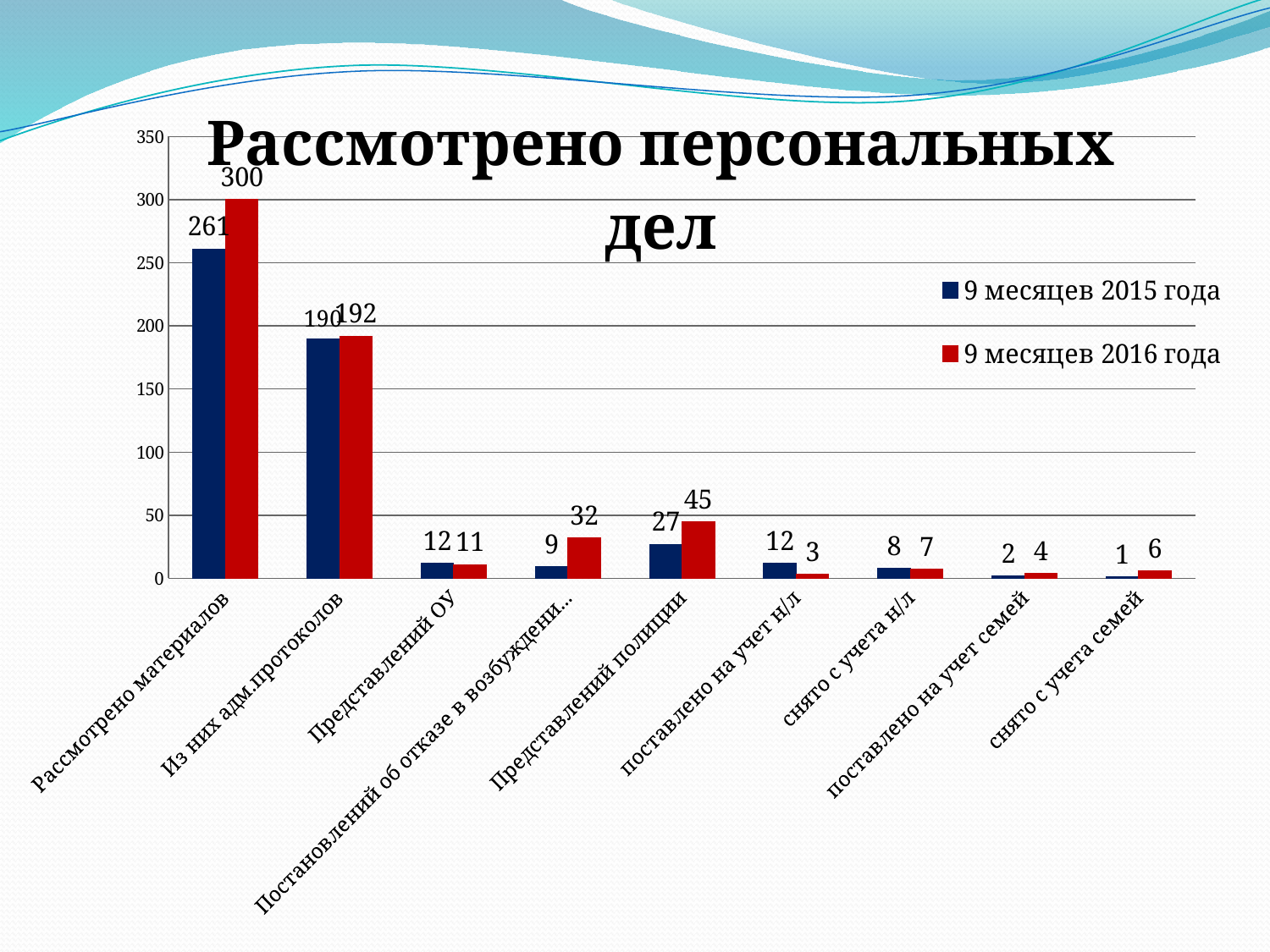
What is the value for "Рассмотрено материалов" in the "9 месяцев 2016 года" series? 300 What is the difference between the "9 месяцев 2016 года" and "9 месяцев 2015 года" values for "Рассмотрено материалов"? 39 Which category has the lowest value in the "9 месяцев 2015 года" series? снято с учета семей How many series does the legend list? 2 What is the value for "Представлений полиции" in the "9 месяцев 2016 года" series? 45 What is the title of the chart? Рассмотрено персональных дел Is the value for "Из них адм.протоколов" in the "9 месяцев 2016 года" series greater or less than 150? greater What is the value for "Из них адм.протоколов" in the "9 месяцев 2015 года" series? 190 Which category has the highest value in the "9 месяцев 2015 года" series? Рассмотрено материалов What type of chart is shown on the slide? bar chart For "поставлено на учет н/л", which series has the larger value, "9 месяцев 2015 года" or "9 месяцев 2016 года"? 9 месяцев 2015 года How many categories are shown on the x axis? 9